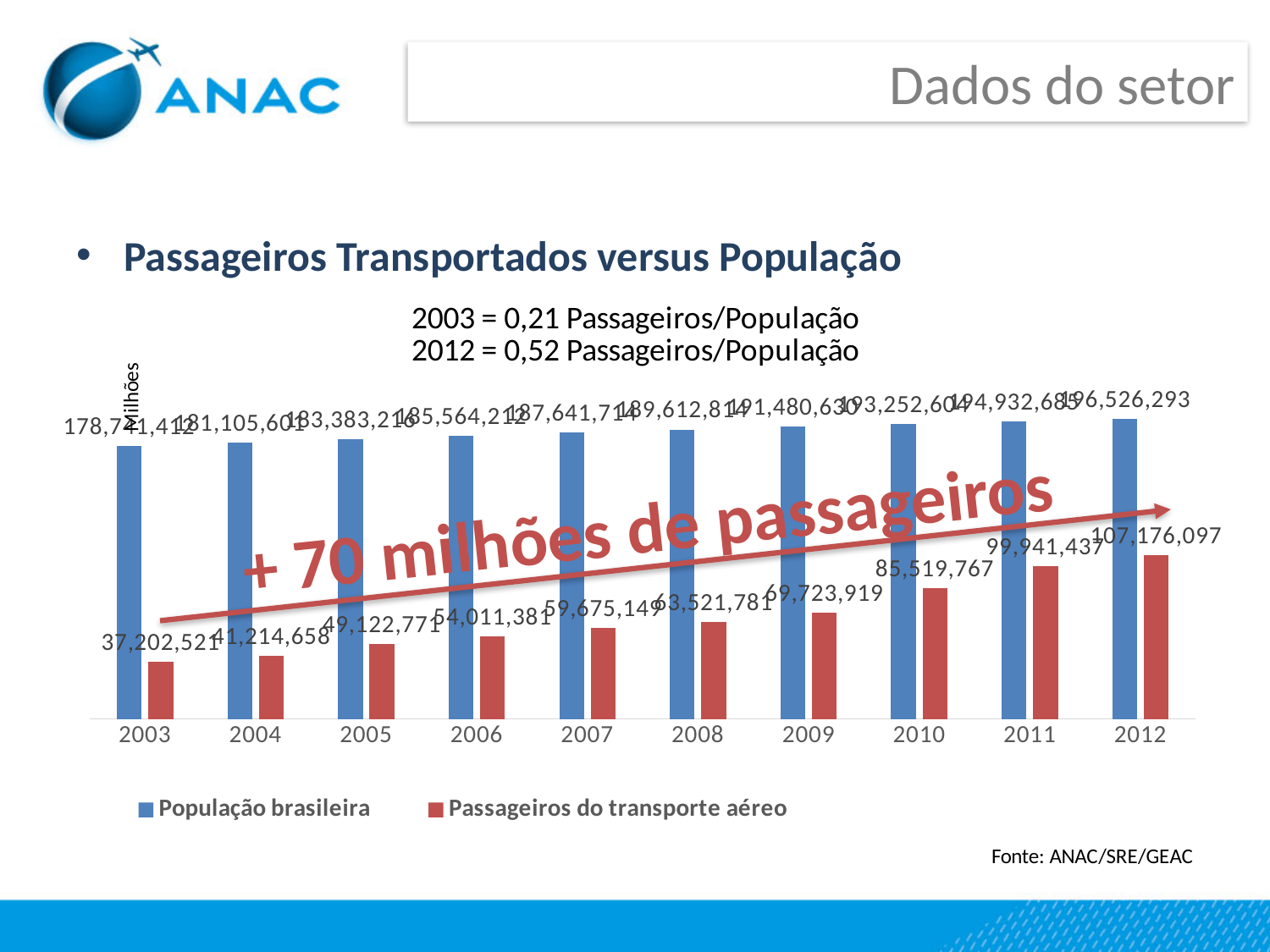
Do the values for Passageiros do transporte aéreo rise or fall from 2003 to 2012? Rise Which series has the larger value in 2012, População brasileira or Passageiros do transporte aéreo? População brasileira What type of chart is shown on the slide? Bar chart In which year is Passageiros do transporte aéreo highest? 2012 How many series does the chart legend list? 2 What is the value of Passageiros do transporte aéreo for 2011? 99,941,437 What is the value of População brasileira for 2012? 196,526,293 How many years are shown on the x axis of the chart? 10 What is the difference between Passageiros do transporte aéreo in 2012 and in 2011? 7,234,660 In which year is Passageiros do transporte aéreo lowest? 2003 What is the value of Passageiros do transporte aéreo for 2012? 107,176,097 What is the value of Passageiros do transporte aéreo for 2010? 85,519,767